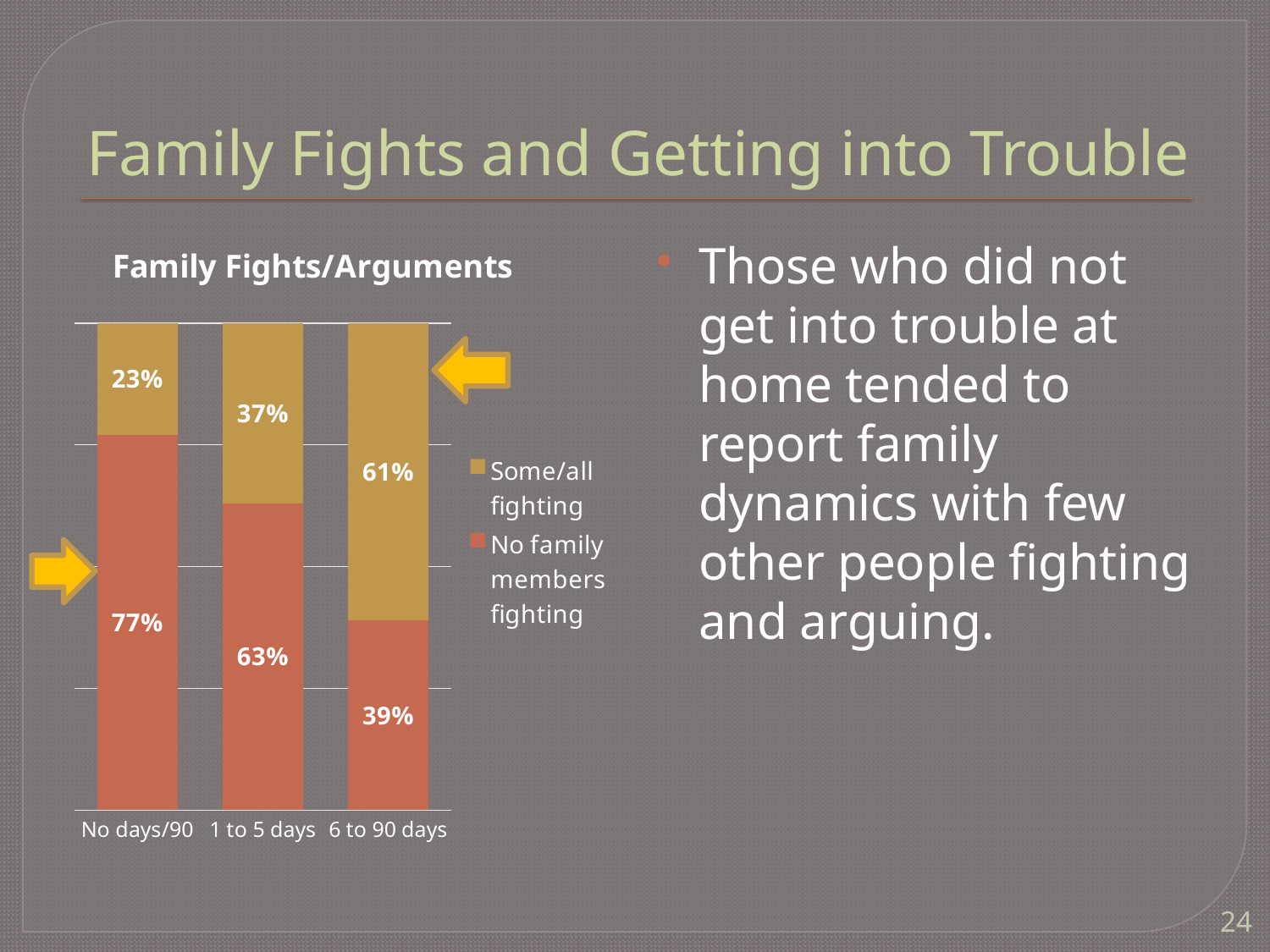
Which category has the lowest value for 'Some/all fighting'? No days/90 Which category has the highest value for 'No family members fighting'? No days/90 What kind of chart is shown on the slide? Stacked bar chart Which is larger: 'Some/all fighting' for '1 to 5 days' or 'Some/all fighting' for '6 to 90 days'? 6 to 90 days What is the value for 'No family members fighting' in the 'No days/90' category? 77% What is the value for 'No family members fighting' in the '6 to 90 days' category? 39% What is the value for 'Some/all fighting' in the '1 to 5 days' category? 37% What is the difference between the 'No family members fighting' values for 'No days/90' and '6 to 90 days'? 38% What is the title of the chart? Family Fights/Arguments What is the value for 'Some/all fighting' in the '6 to 90 days' category? 61% How many series does the legend list? 2 How many categories are shown on the x axis? 3